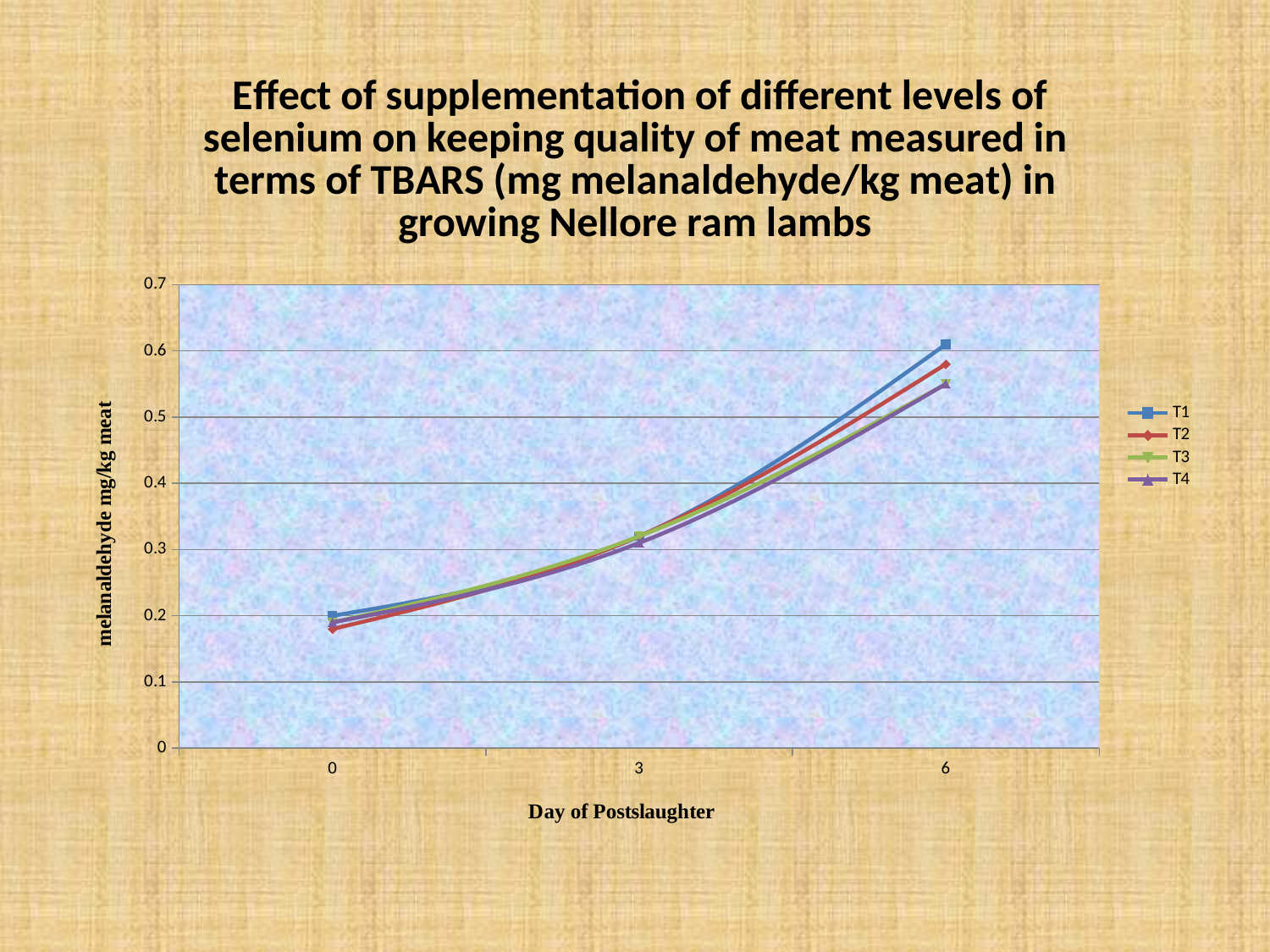
Which series has the highest value at day 6 of postslaughter? T1 At day 6 of postslaughter, which is larger, T1 or T2? T1 How many series does the legend list? 4 Is the value for T1 at day 3 greater or less than 0.4? less What kind of chart is shown on the slide? line chart What is the title of the x axis? Day of Postslaughter What is the title of the y axis? melanaldehyde mg/kg meat Is the value for T2 at day 6 greater or less than 0.5? greater At day 6 of postslaughter, which is larger, T1 or T4? T1 Do the TBARS values rise or fall from day 0 to day 6 of postslaughter? rise Is the value for T1 at day 0 greater or less than 0.3? less How many days of postslaughter are plotted on the x axis? 3